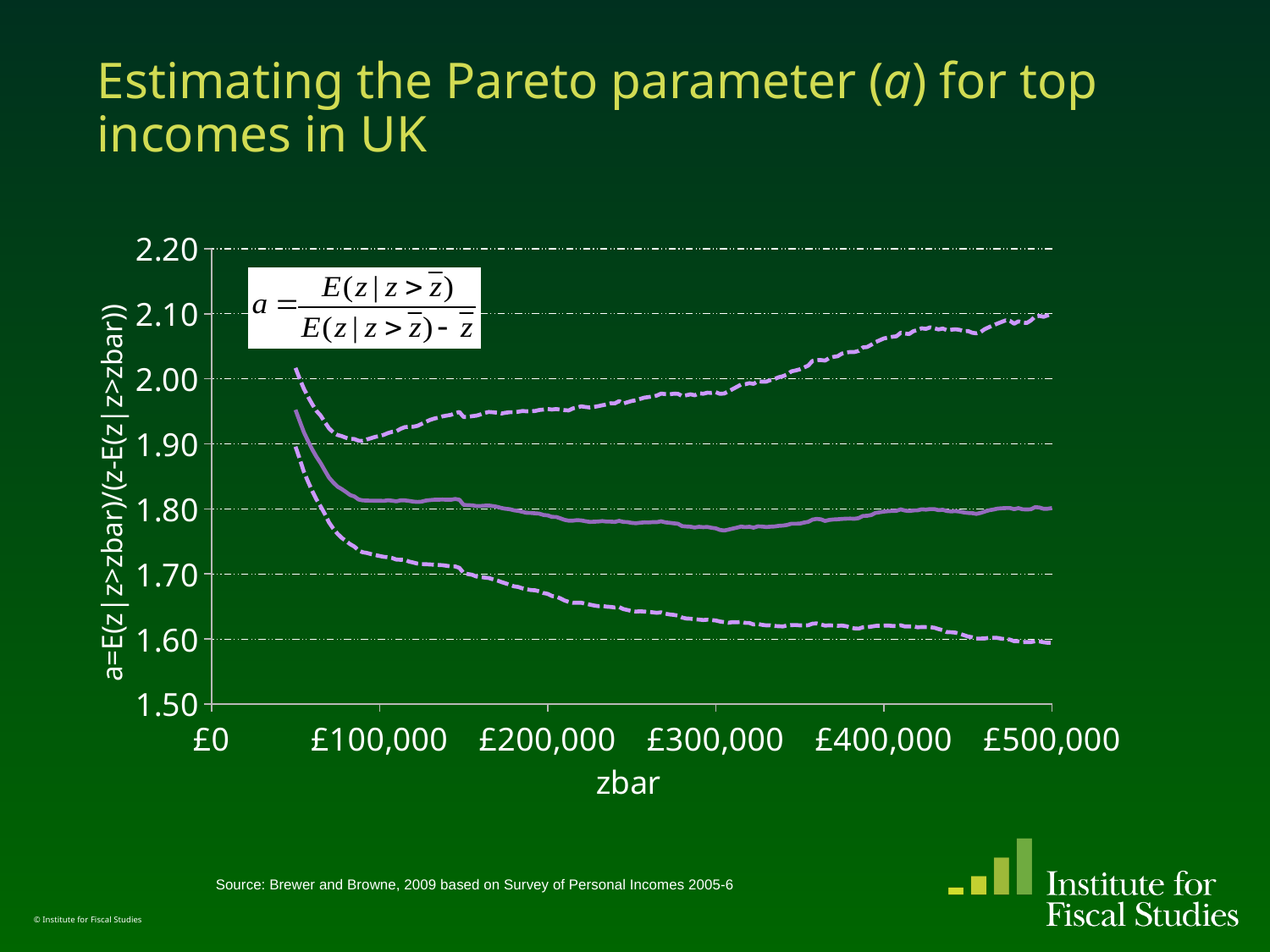
Is the value of the lower dashed line at £200,000 greater or less than 1.70? less Is the value of the upper dashed line at £300,000 greater or less than 2.00? less What kind of chart is shown on the slide? line chart What is the highest value shown on the y axis? 2.20 Does the lower dashed line rise or fall between £100,000 and £500,000? fall Is the value of the lower dashed line at £300,000 greater or less than 1.60? greater What is the label of the x axis? zbar Does the upper dashed line rise or fall between £100,000 and £500,000? rise How many lines are plotted on the chart? 3